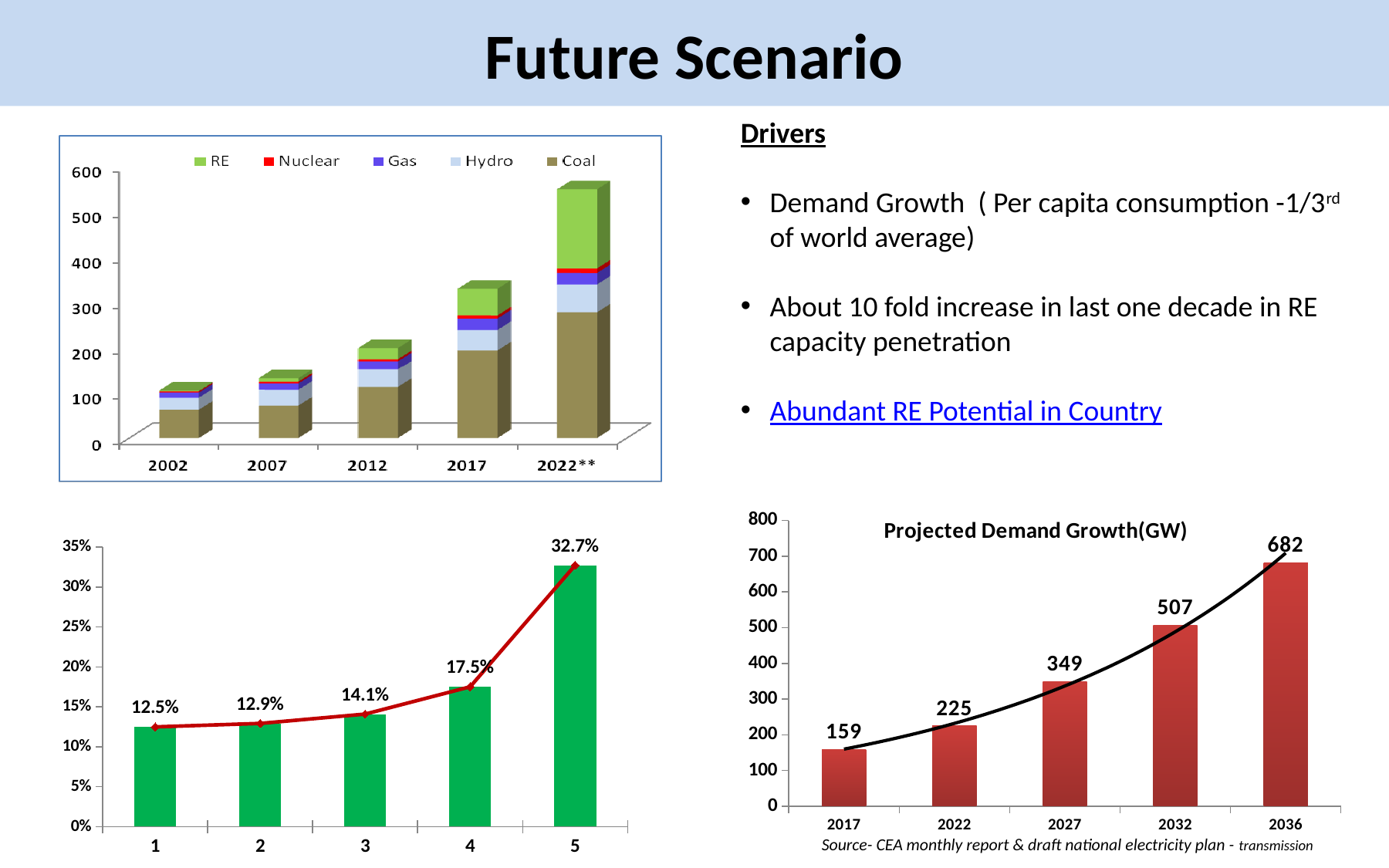
In the Projected Demand Growth(GW) chart, which year has the lowest value? 2017 In the bottom-left percentage chart, is the value for category 3 greater or less than 15%? less In the Projected Demand Growth(GW) chart, what is the difference between the 2032 and 2022 values? 282 In the Projected Demand Growth(GW) chart, how many years are shown on the x axis? 5 In the Projected Demand Growth(GW) chart, what is the value for 2036? 682 In the Projected Demand Growth(GW) chart, do the values rise or fall from 2017 to 2036? rise In the Projected Demand Growth(GW) chart, what is the value for 2027? 349 In the top-left stacked chart, how many series does the legend list? 5 In the bottom-left percentage chart, which category has the highest value? 5 In the top-left stacked chart, is the total for 2022** greater or less than 500? greater In the bottom-left percentage chart, what is the value for category 4? 17.5% In the bottom-left percentage chart, what is the difference between the values for category 5 and category 1? 20.2%